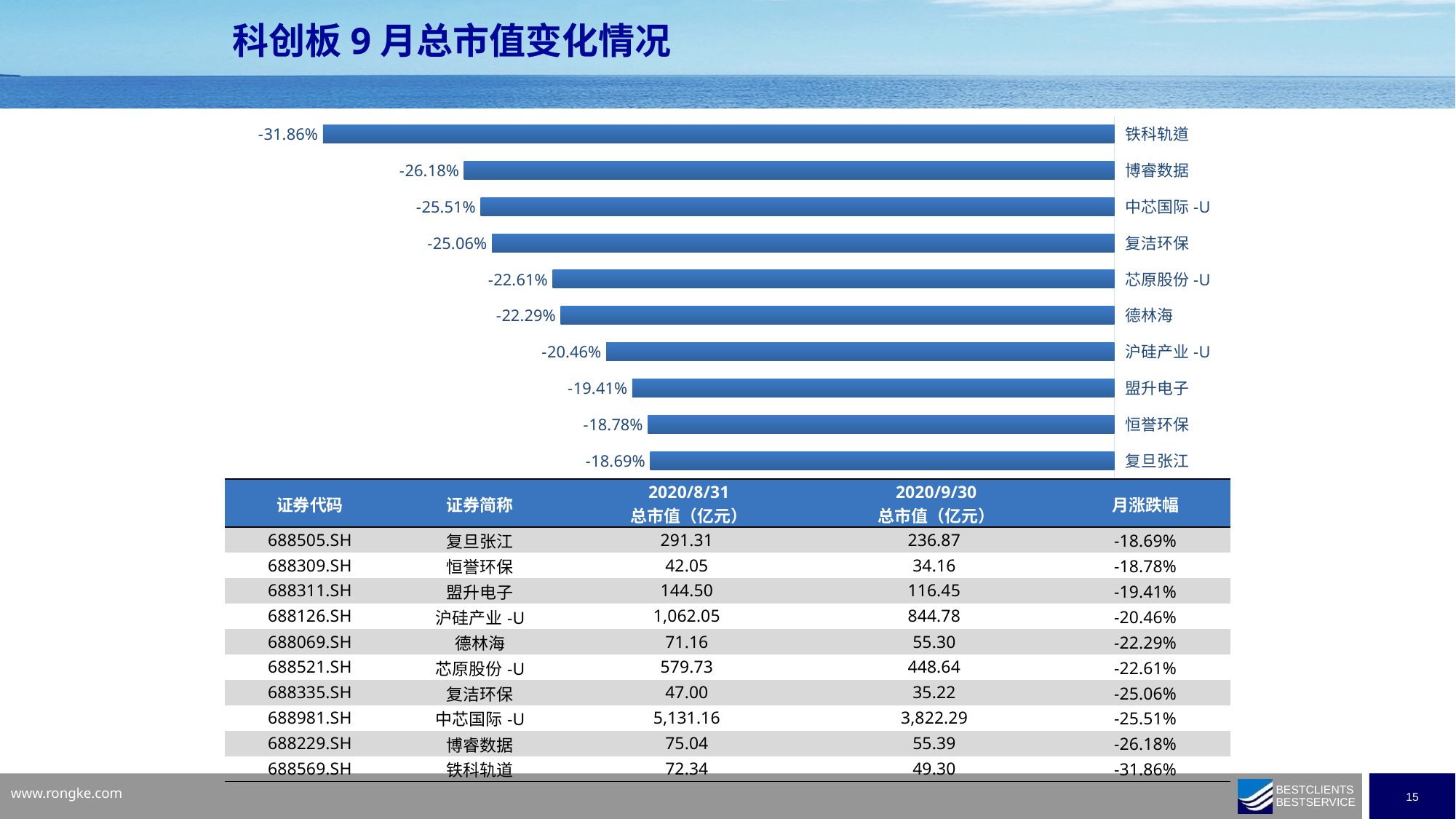
Which company has the smallest decline (highest value) in the chart? 复旦张江 What is the monthly change shown for 德林海 in the chart? -22.29% What colour are the bars in the chart? blue What is the monthly change shown for 复旦张江 in the chart? -18.69% What is the monthly change shown for 铁科轨道 in the chart? -31.86% How many companies are shown as bars in the chart? 10 What is the monthly change shown for 沪硅产业-U in the chart? -20.46% Which company has the largest decline (lowest value) in the chart? 铁科轨道 What type of chart is shown on the slide? bar chart What is the difference in percentage points between the values for 铁科轨道 and 博睿数据? 5.68 percentage points Which company shows a larger decline, 芯原股份-U or 盟升电子? 芯原股份-U What is the difference in percentage points between the values for 中芯国际-U and 复洁环保? 0.45 percentage points